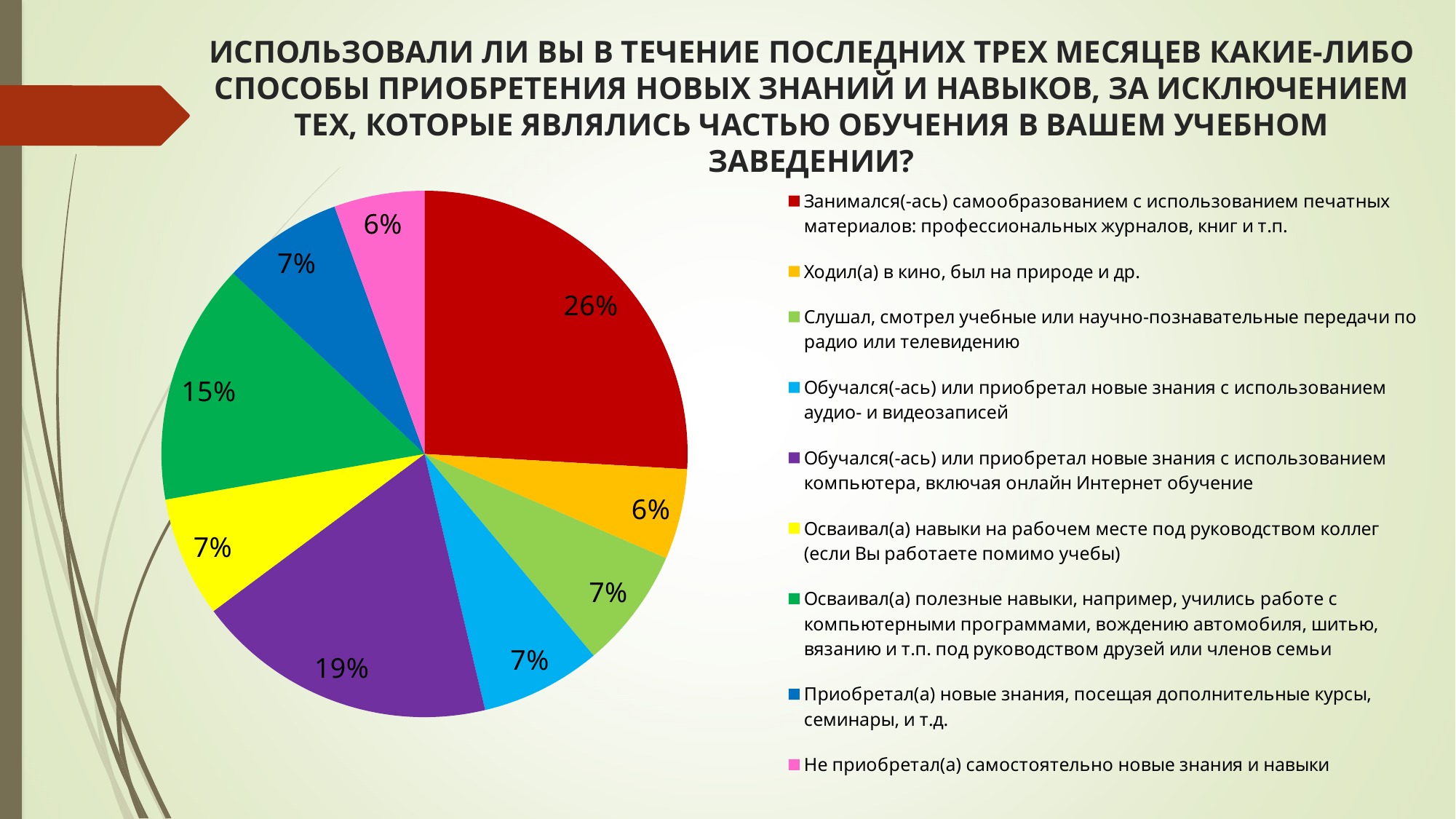
What percentage is shown for "Не приобретал(а) самостоятельно новые знания и навыки"? 6% What percentage is shown for "Осваивал(а) полезные навыки ... под руководством друзей или членов семьи"? 15% What is the difference in percentage points between the slice for self-education with printed materials (26%) and the slice for learning with a computer (19%)? 7 What colour is the slice for "Ходил(а) в кино, был на природе и др."? orange What share of the pie is labelled for "Занимался(-ась) самообразованием с использованием печатных материалов"? 26% Which is larger: the slice for "Обучался(-ась) ... с использованием компьютера" or the slice for "Осваивал(а) полезные навыки ... под руководством друзей или членов семьи"? Обучался(-ась) ... с использованием компьютера What type of chart is shown on the slide? pie chart How many entries does the legend list? 9 What percentage is shown for "Приобретал(а) новые знания, посещая дополнительные курсы, семинары, и т.д."? 7% How many slices does the pie chart have? 9 What percentage is shown for "Обучался(-ась) или приобретал новые знания с использованием компьютера, включая онлайн Интернет обучение"? 19% Which category has the largest slice of the pie? Занимался(-ась) самообразованием с использованием печатных материалов: профессиональных журналов, книг и т.п.